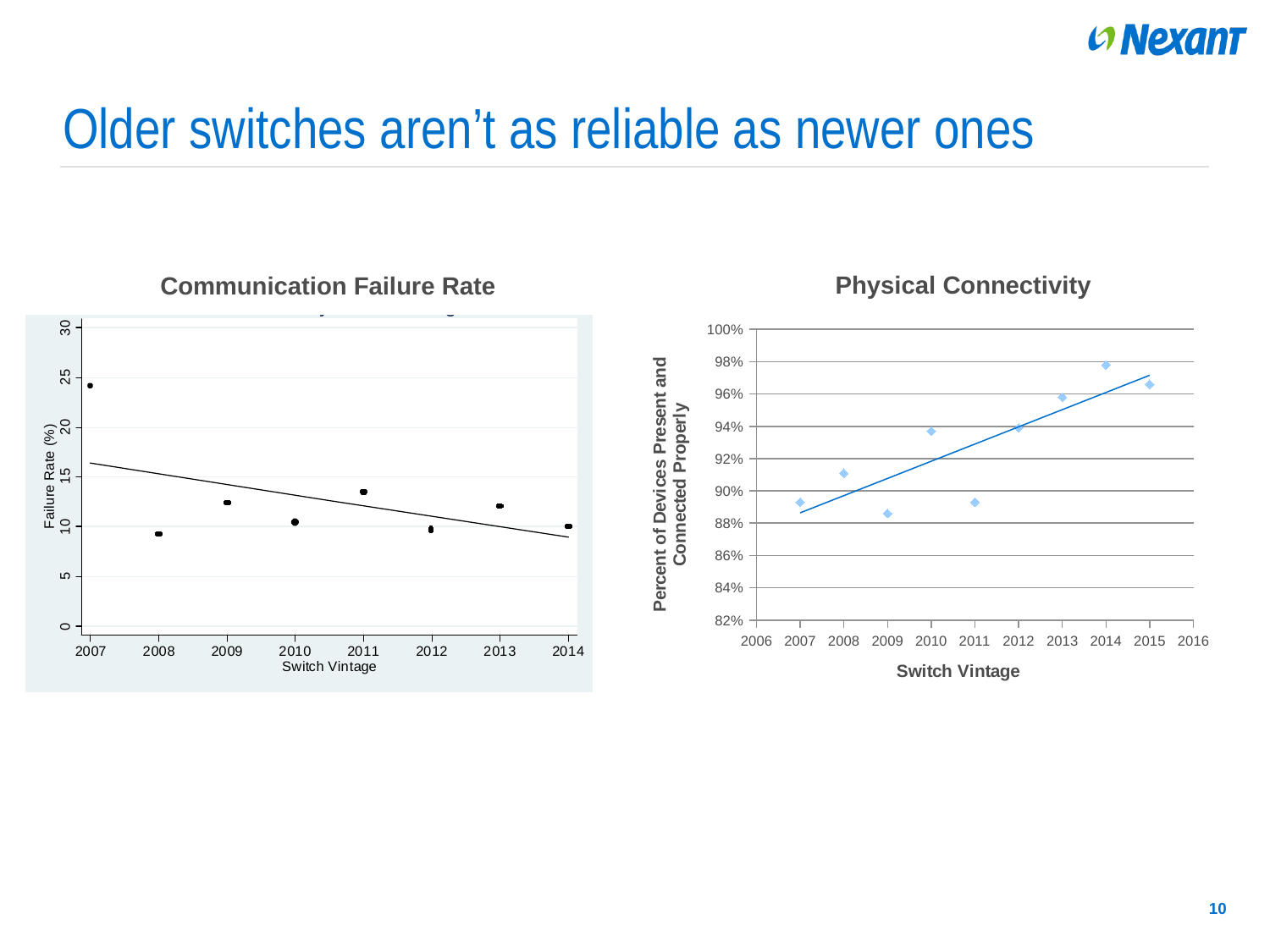
In the Physical Connectivity chart, is the value for 2014 greater or less than 96%? greater What kind of chart is the Communication Failure Rate chart? scatter chart In the Communication Failure Rate chart, how many switch vintages are plotted? 8 In the Communication Failure Rate chart, is the failure rate for 2008 greater or less than 10? less In the Physical Connectivity chart, how many data points are plotted? 9 In the Physical Connectivity chart, is the value for 2009 greater or less than 90%? less In the Communication Failure Rate chart, does the trend line rise or fall from 2007 to 2014? fall What is the x-axis label of the Physical Connectivity chart? Switch Vintage In the Communication Failure Rate chart, which switch vintage has the highest failure rate? 2007 In the Physical Connectivity chart, which switch vintage has the highest percent of devices present and connected properly? 2014 In the Physical Connectivity chart, which is larger, the value for 2013 or the value for 2008? 2013